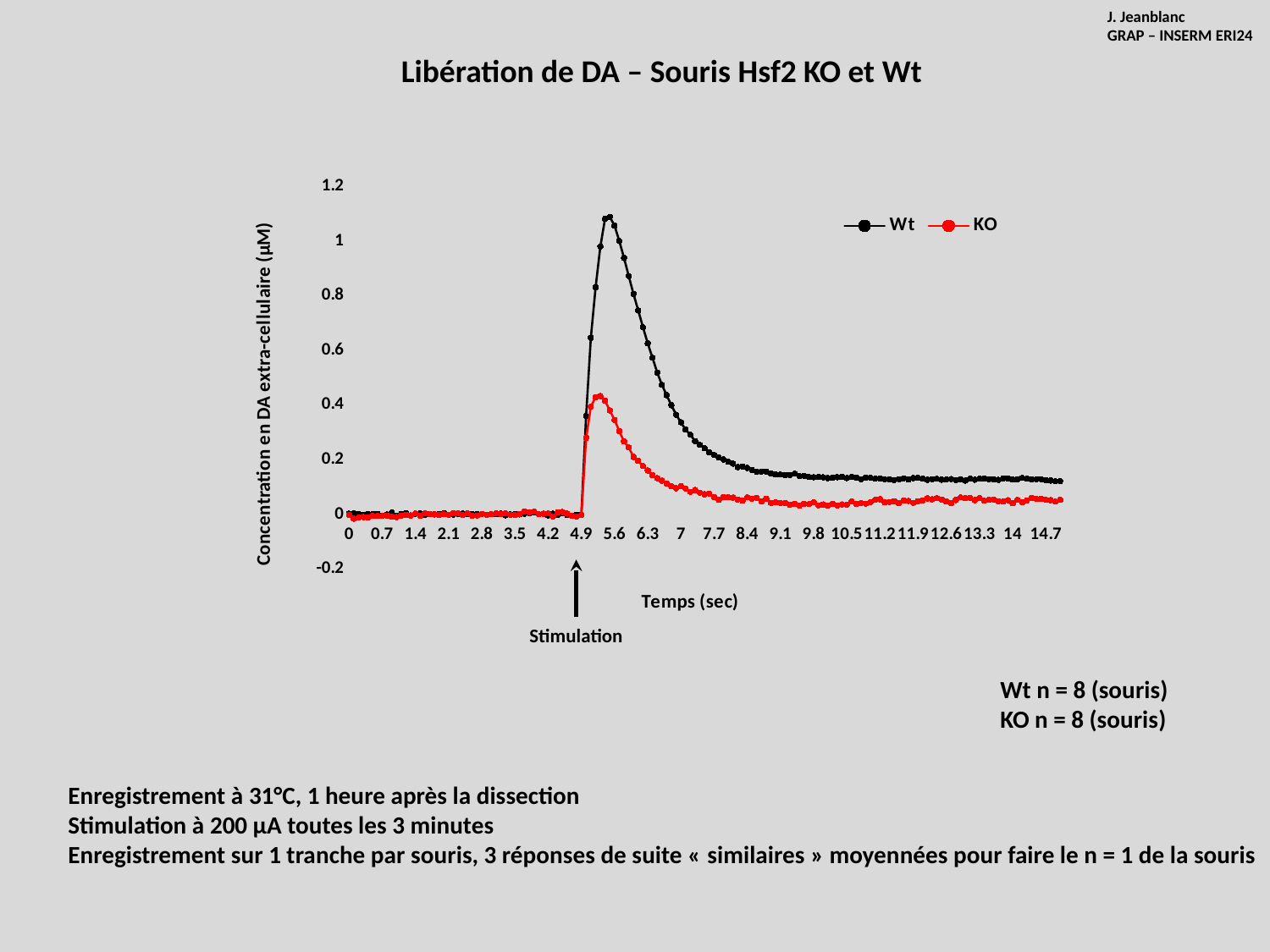
What is the title of the chart? Libération de DA – Souris Hsf2 KO et Wt Is the Wt value at 14.7 seconds greater or less than 0.4? less Which series has the higher value at 14.7 seconds, Wt or KO? Wt After the peak at around 5.6 seconds, do the Wt values rise or fall as time increases? fall Is the peak value of the Wt series greater or less than 0.8? greater How many series does the legend list? 2 Is the peak value of the KO series greater or less than 0.2? greater What are the two series named in the legend? Wt and KO What kind of chart is shown on the slide? line chart Which series reaches the higher peak concentration, Wt or KO? Wt What colour is the KO series line? red